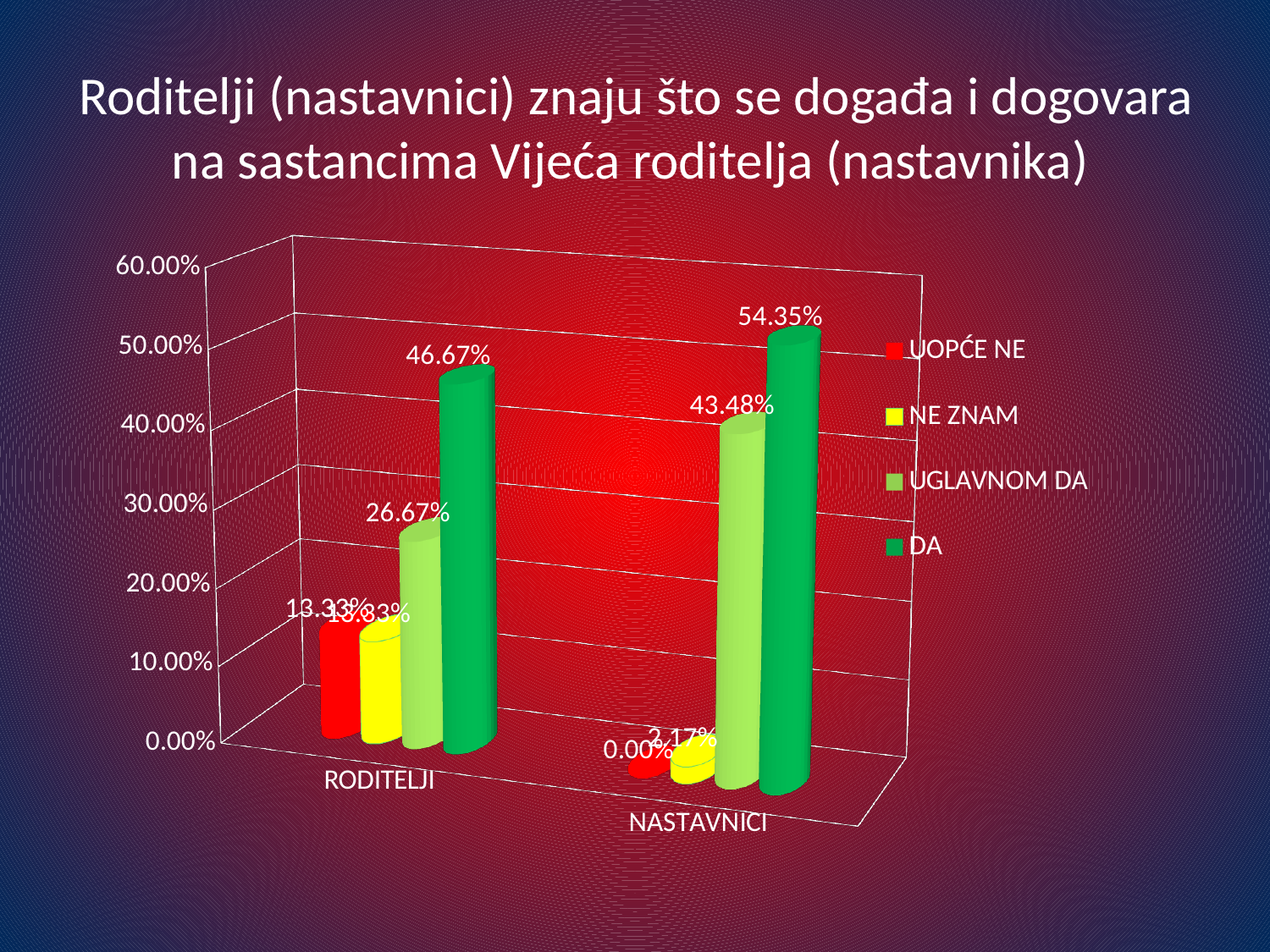
What is the difference between the DA value for NASTAVNICI and the DA value for RODITELJI? 7.68 percentage points Which series has the lowest value in the NASTAVNICI category? UOPĆE NE How many series does the legend list? 4 Which category has the larger UGLAVNOM DA value, RODITELJI or NASTAVNICI? NASTAVNICI What is the value for UOPĆE NE in the NASTAVNICI category? 0.00% What is the value for DA in the NASTAVNICI category? 54.35% Which series has the highest value in the NASTAVNICI category? DA What is the value for UGLAVNOM DA in the RODITELJI category? 26.67% What is the value for DA in the RODITELJI category? 46.67% What is the value for UGLAVNOM DA in the NASTAVNICI category? 43.48% What is the value for NE ZNAM in the NASTAVNICI category? 2.17% Is the value for UOPĆE NE in the RODITELJI category greater or less than 20.00%? less